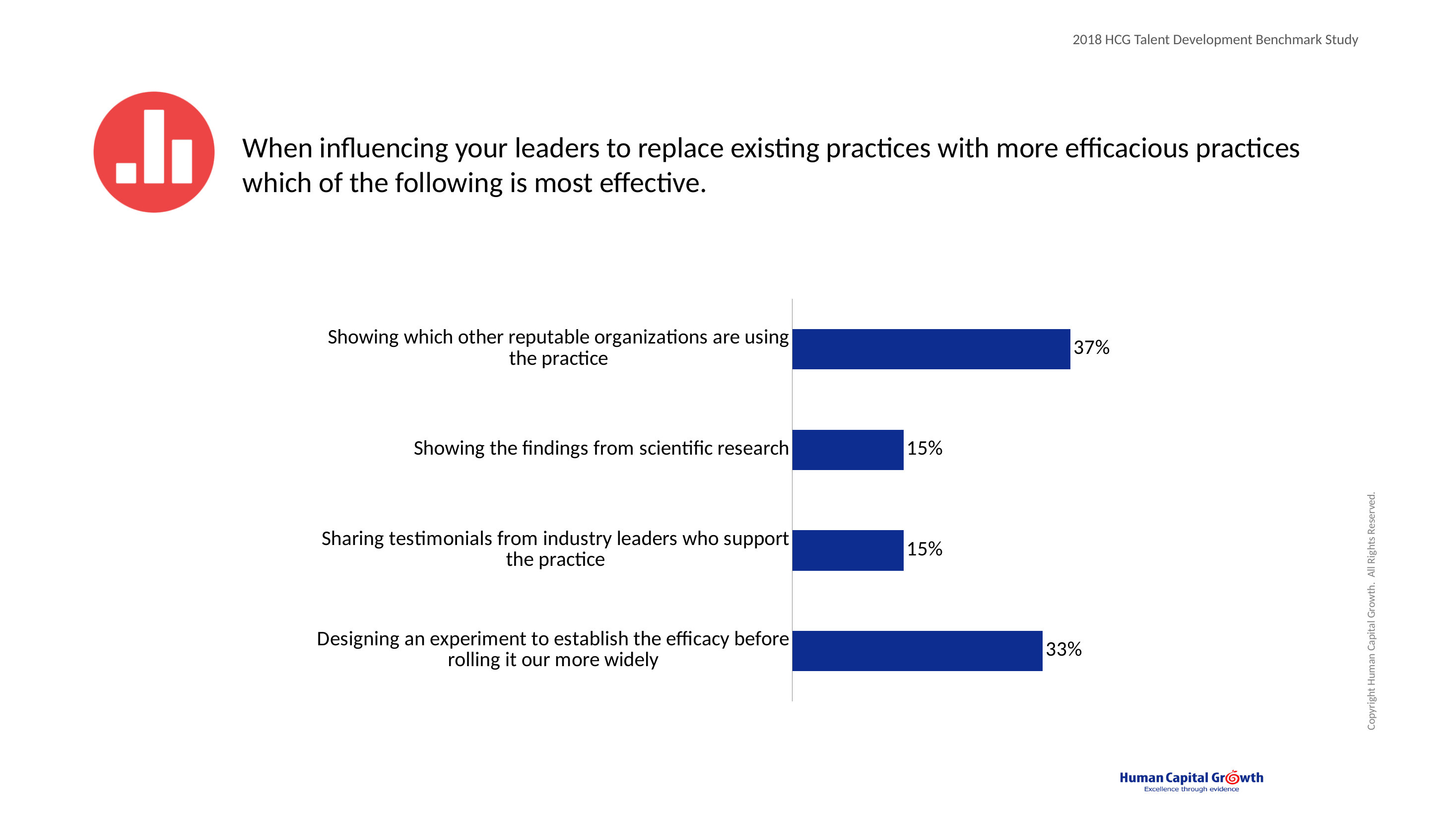
What is the difference between the highest value and the value for 'Designing an experiment to establish the efficacy before rolling it our more widely'? 4% What is the value for 'Sharing testimonials from industry leaders who support the practice'? 15% What type of chart is shown on the slide? Bar chart Which option has the highest percentage? Showing which other reputable organizations are using the practice How many options share the same value of 15%? 2 What percentage of respondents chose 'Showing which other reputable organizations are using the practice' as most effective? 37% What is the value for 'Showing the findings from scientific research'? 15% How many options (categories) are shown in the chart? 4 What is the value for 'Designing an experiment to establish the efficacy before rolling it our more widely'? 33% Which is larger: the value for 'Designing an experiment to establish the efficacy before rolling it our more widely' or the value for 'Showing the findings from scientific research'? Designing an experiment to establish the efficacy before rolling it our more widely What colour are the bars in the chart? Dark blue What is the difference between 'Showing which other reputable organizations are using the practice' and 'Showing the findings from scientific research'? 22%